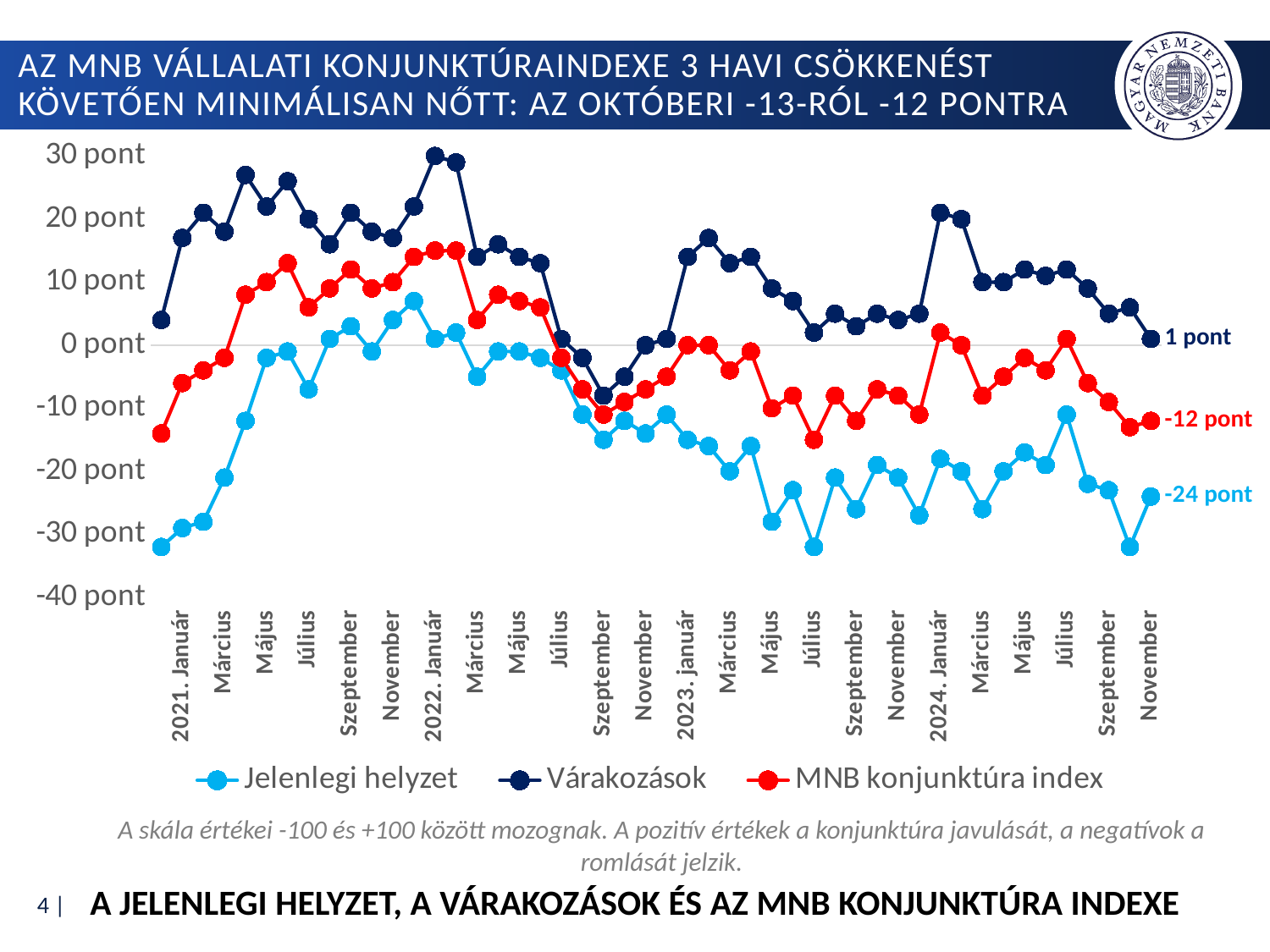
Is the value of Várakozások in 2021 Május greater or less than 20 pont? greater What kind of chart is shown on the slide? line chart What is the value of the Várakozások series in November 2024, as labelled at the end of the line? 1 pont What is the difference between the Várakozások value (1 pont) and the MNB konjunktúra index value (-12 pont) in November 2024? 13 pont How many series does the legend list? 3 Which colour is used for the MNB konjunktúra index series in the legend? red In November 2024, which series has the highest value? Várakozások Does the Jelenlegi helyzet series rise or fall between 2021. január and 2021 Május? rise What is the value of the MNB konjunktúra index in November 2024, as labelled at the end of the line? -12 pont In November 2024, which series has the lowest value? Jelenlegi helyzet What is the value of the Jelenlegi helyzet series in November 2024, as labelled at the end of the line? -24 pont